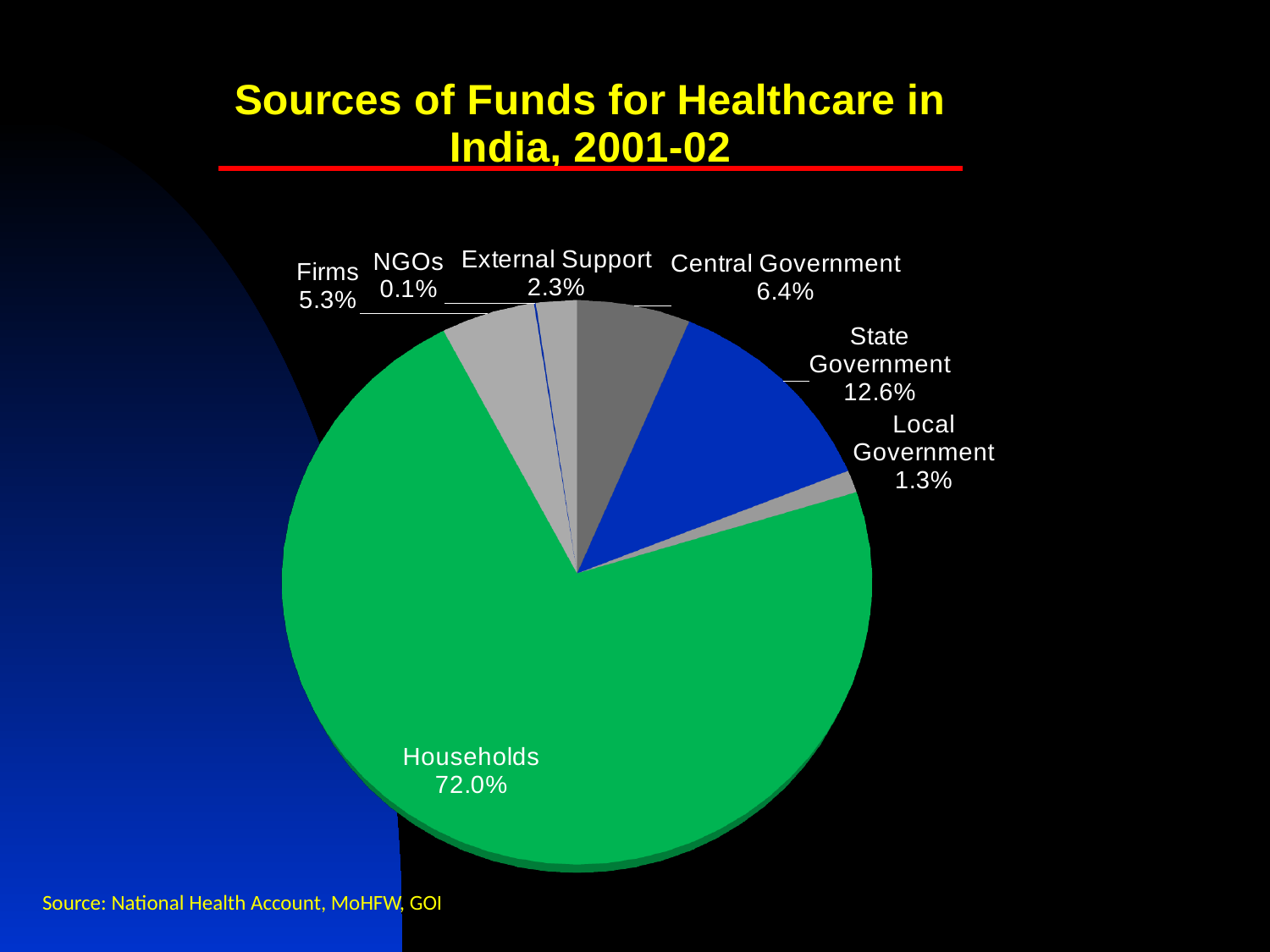
What kind of chart is shown on the slide? Pie chart Which source of funds has the smallest share? NGOs What percentage of funds comes from State Government? 12.6% What percentage of funds comes from Firms? 5.3% What is the share for External Support? 2.3% Which source of funds has the largest share? Households What is the share for Central Government? 6.4% Which is larger, the share for Firms or the share for Local Government? Firms How many sources of funds are shown in the pie chart? 7 What is the title of the chart? Sources of Funds for Healthcare in India, 2001-02 What share of healthcare funds comes from Households? 72.0% What is the difference between the State Government share and the Central Government share? 6.2%